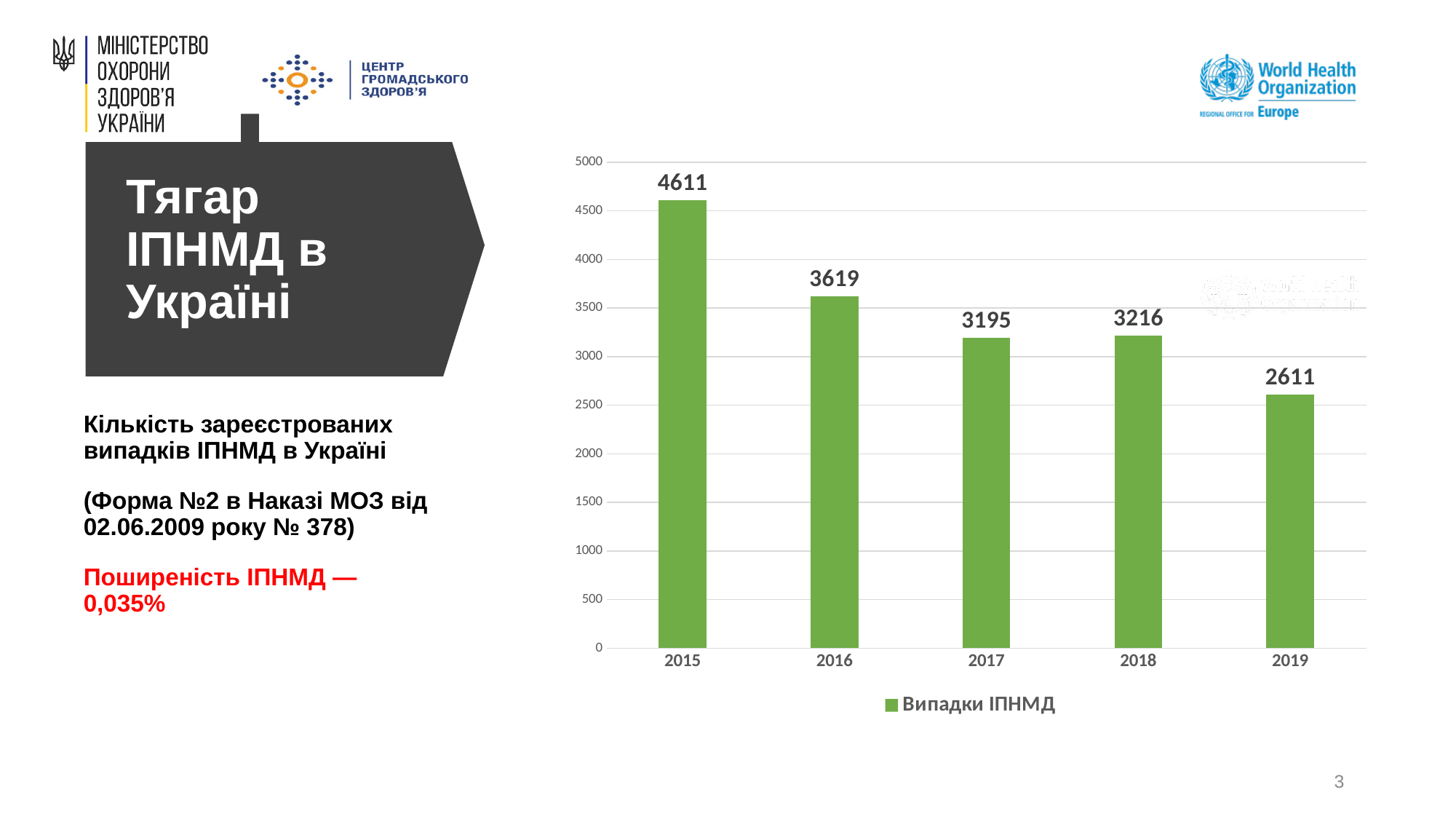
Is the value for 2019 greater or less than 3000? less Which is larger, the value for 2016 or the value for 2018? 2016 How many years are shown on the x axis? 5 Which year has the highest value? 2015 What is the value for 2019? 2611 What kind of chart is shown on the slide? bar chart What is the value for 2017? 3195 What is the difference between the values for 2018 and 2019? 605 What is the difference between the values for 2015 and 2016? 992 Which year has the lowest value? 2019 What is the value for 2015? 4611 What is the legend entry for the series shown in the chart? Випадки ІПНМД